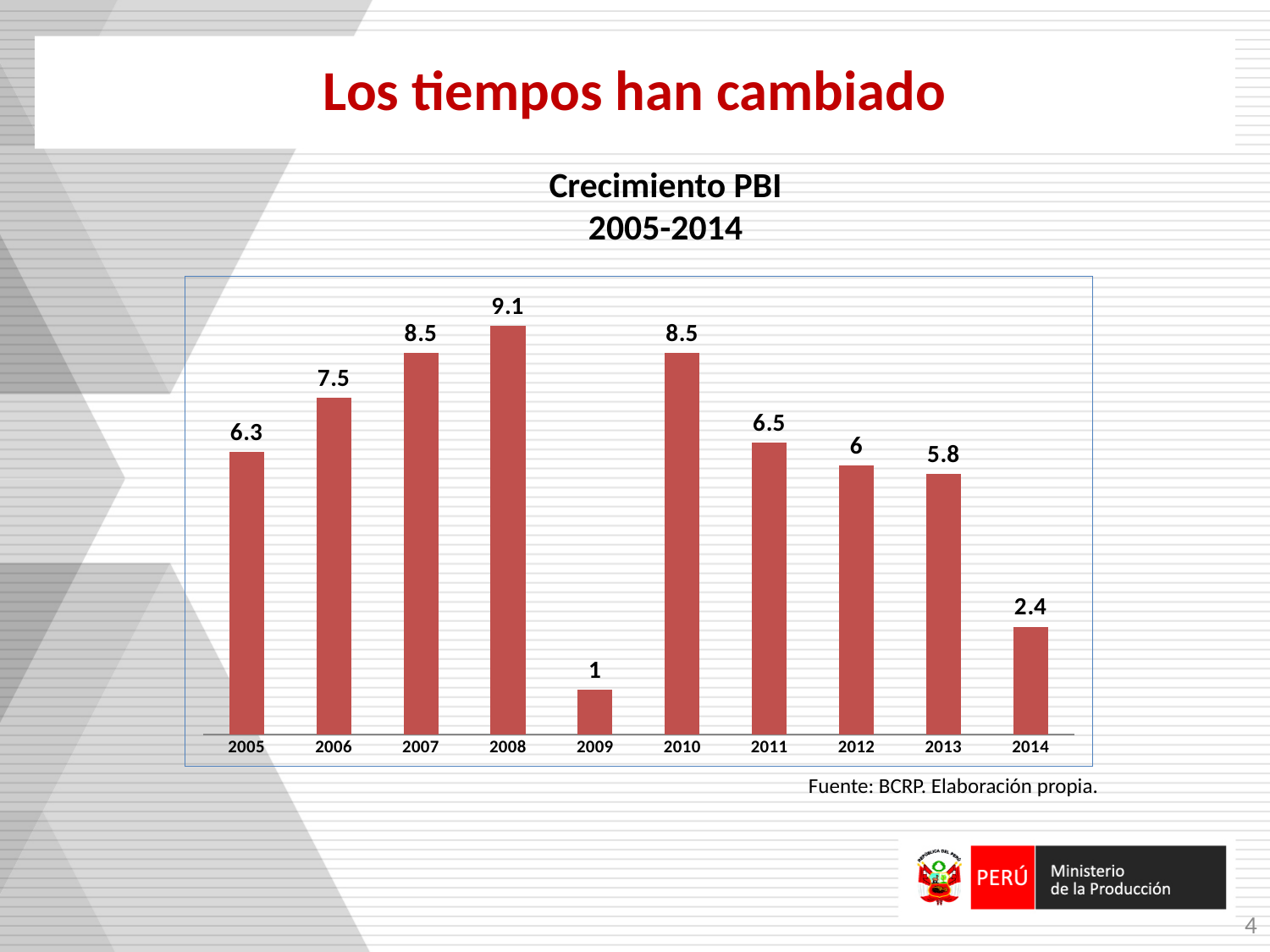
What is the value for 2009? 1 What is the value for 2014? 2.4 What is the difference between the values for 2013 and 2014? 3.4 Which year has the lowest value? 2009 Which year has the highest value? 2008 Which is larger, the value for 2006 or the value for 2011? 2006 What is the difference between the values for 2008 and 2009? 8.1 What kind of chart is this? Bar chart Do the values rise or fall from 2010 to 2014? Fall How many years are shown on the x axis? 10 What is the title of the chart? Crecimiento PBI 2005-2014 What is the value for 2008? 9.1